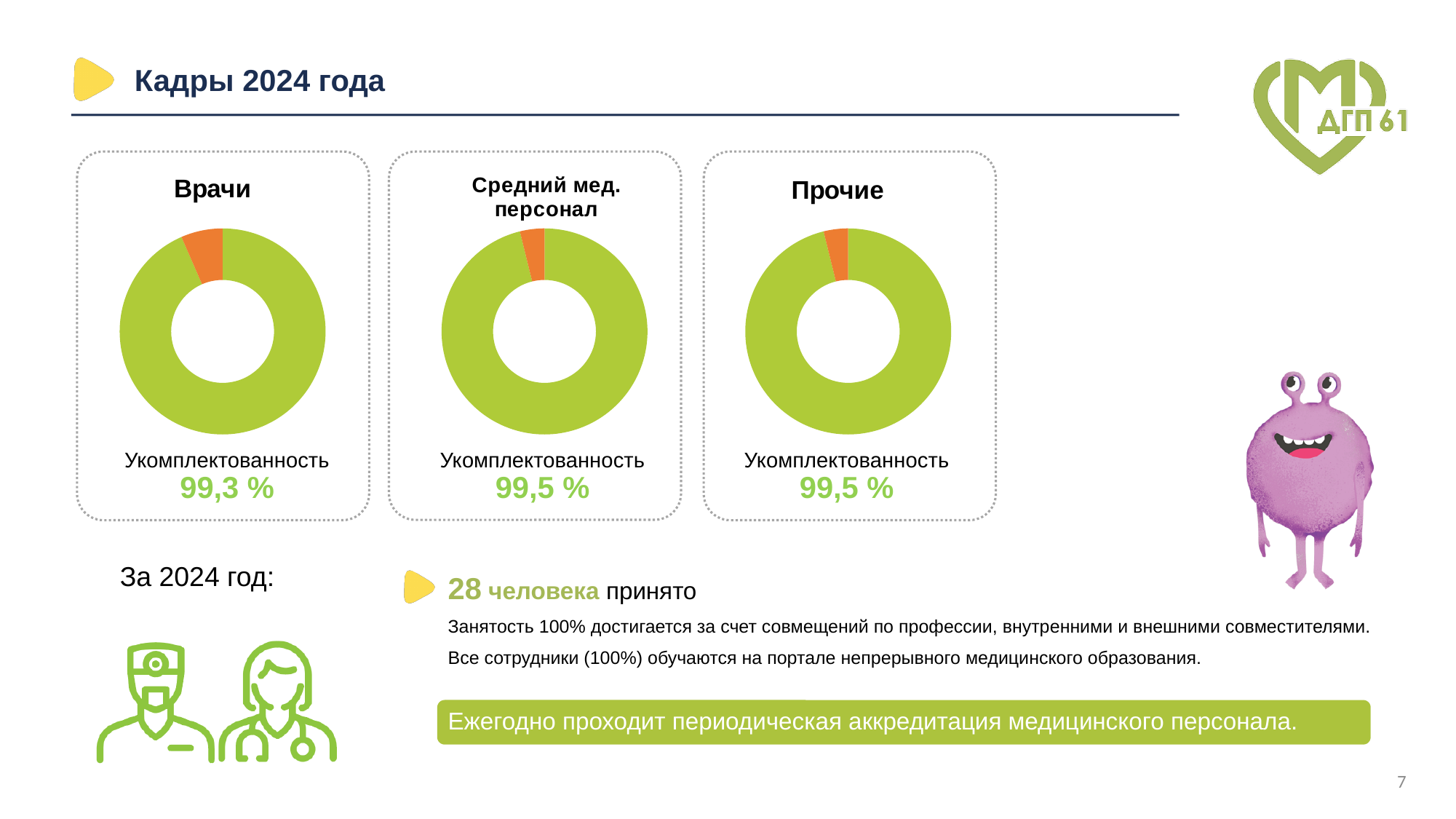
How many slices does each donut chart contain? 2 What kind of chart is used to show the staffing levels on this slide? Donut (pie) chart Which staffing level is higher: 'Врачи' or 'Средний мед. персонал'? Средний мед. персонал What is the staffing level (Укомплектованность) shown for the 'Прочие' chart? 99,5 % How many donut charts are shown on the slide? 3 What is the title of the middle donut chart? Средний мед. персонал What is the staffing level (Укомплектованность) shown for the 'Средний мед. персонал' chart? 99,5 % Which of the three staff categories has the lowest staffing level? Врачи What is the difference between the staffing level for 'Средний мед. персонал' and for 'Врачи'? 0,2 % What is the staffing level (Укомплектованность) shown for the 'Врачи' chart? 99,3 % Which colour represents the staffed share in the donut charts? Green